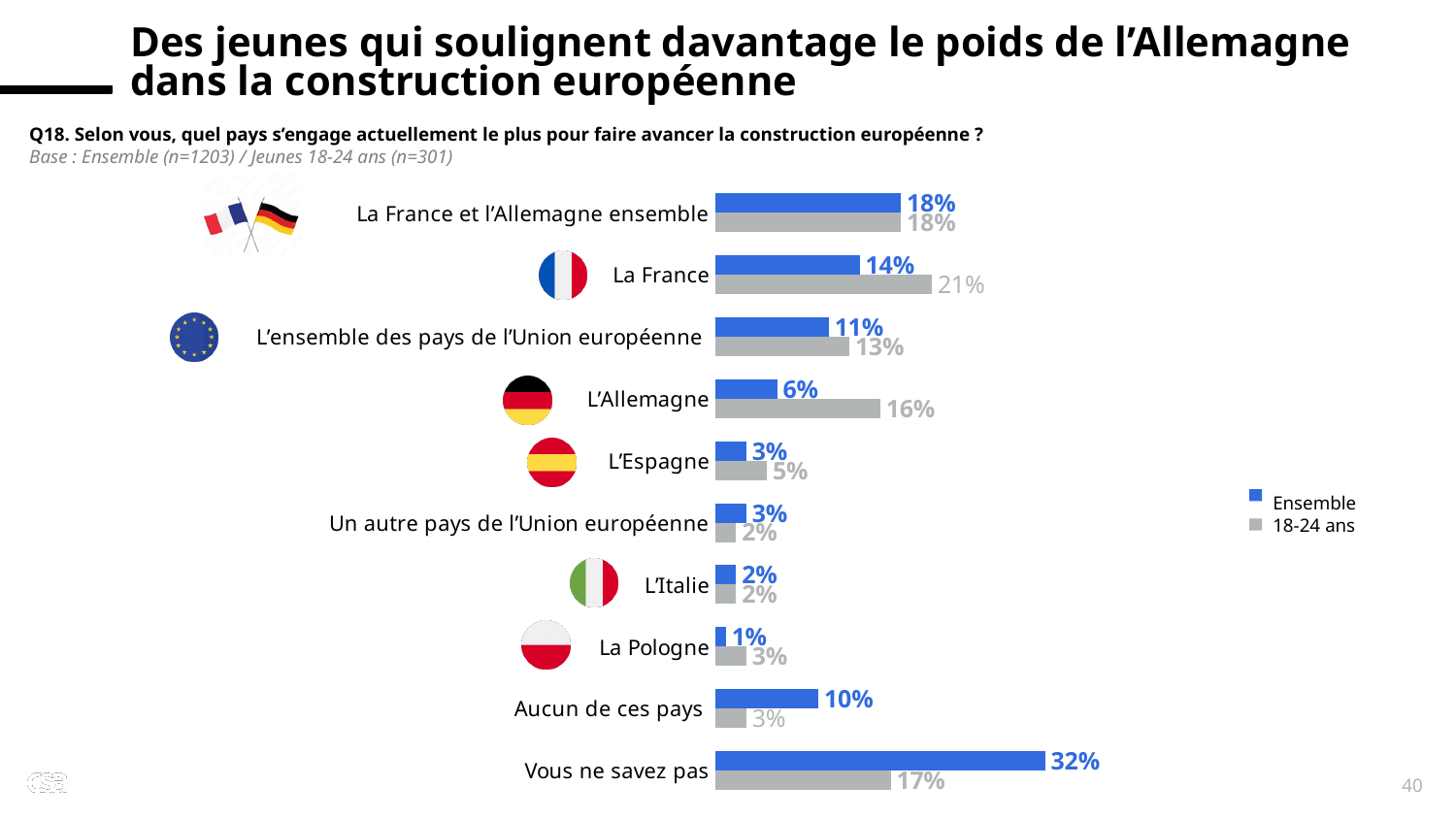
What is the value for "La France" in the "18-24 ans" series? 21% For "Aucun de ces pays", which series has the larger value, "Ensemble" or "18-24 ans"? Ensemble Which colour represents the "18-24 ans" series in the chart? Grey What is the value for "Vous ne savez pas" in the "18-24 ans" series? 17% What is the difference between the "18-24 ans" and "Ensemble" values for "L'Allemagne"? 10 percentage points How many series does the legend list? 2 What is the value for "L'Allemagne" in the "18-24 ans" series? 16% What is the value for "L'Allemagne" in the "Ensemble" series? 6% Which category has the lowest value in the "Ensemble" series? La Pologne Which category has the highest value in the "Ensemble" series? Vous ne savez pas How many categories are shown in the chart? 10 What kind of chart is shown on the slide? Bar chart